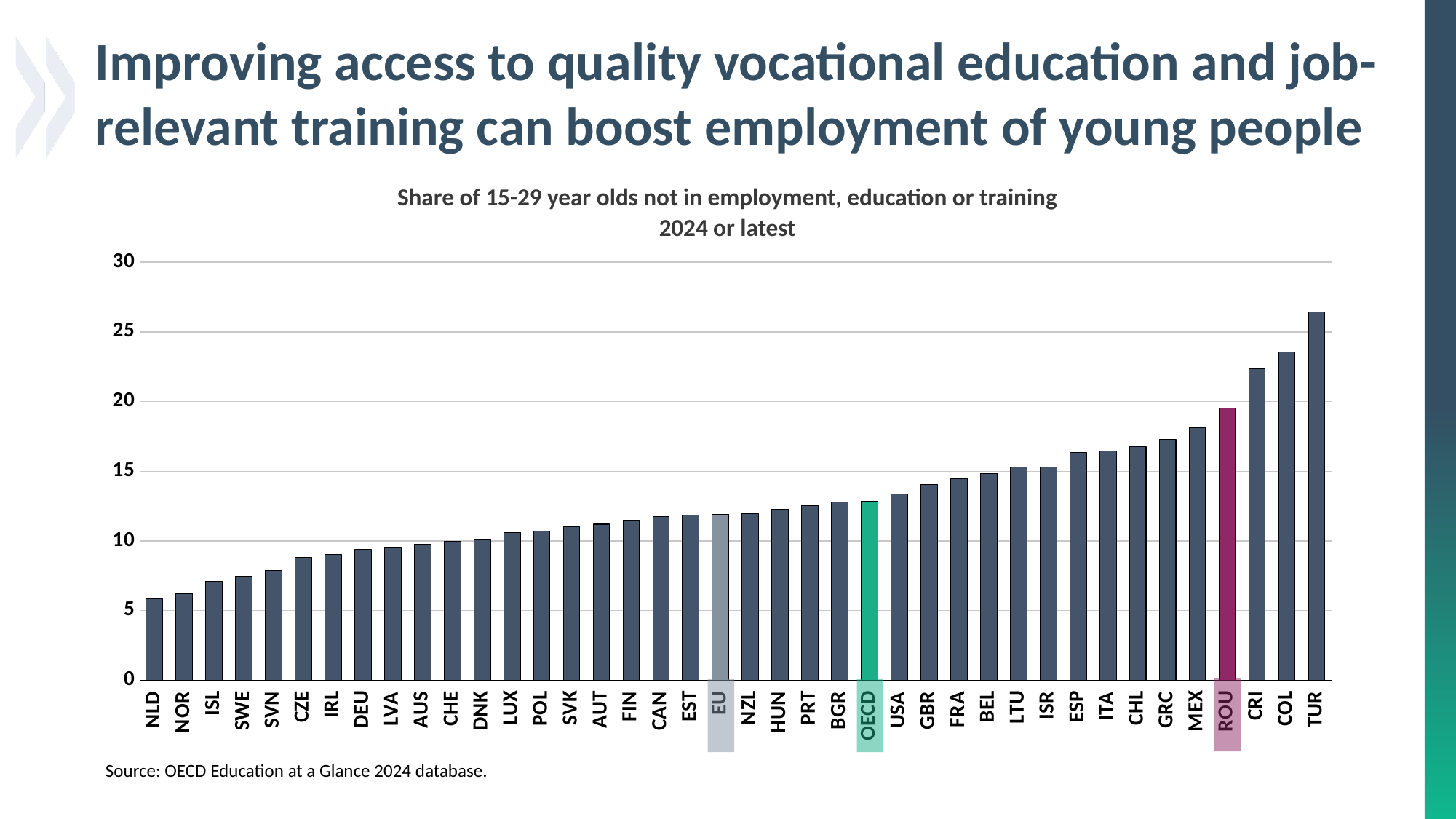
What is the title of the chart? Share of 15-29 year olds not in employment, education or training 2024 or latest Which has the larger value, ROU or OECD? ROU Is the value for TUR greater or less than 25? greater Which country has the lowest share of 15-29 year olds not in employment, education or training? NLD Which country has the highest share of 15-29 year olds not in employment, education or training? TUR What kind of chart is shown on the slide? bar chart Is the value for OECD greater or less than 10? greater Is the value for ISL greater or less than 10? less Do the bar values rise or fall moving from left to right along the x axis? rise How many bars (countries and aggregates) are plotted in the chart? 40